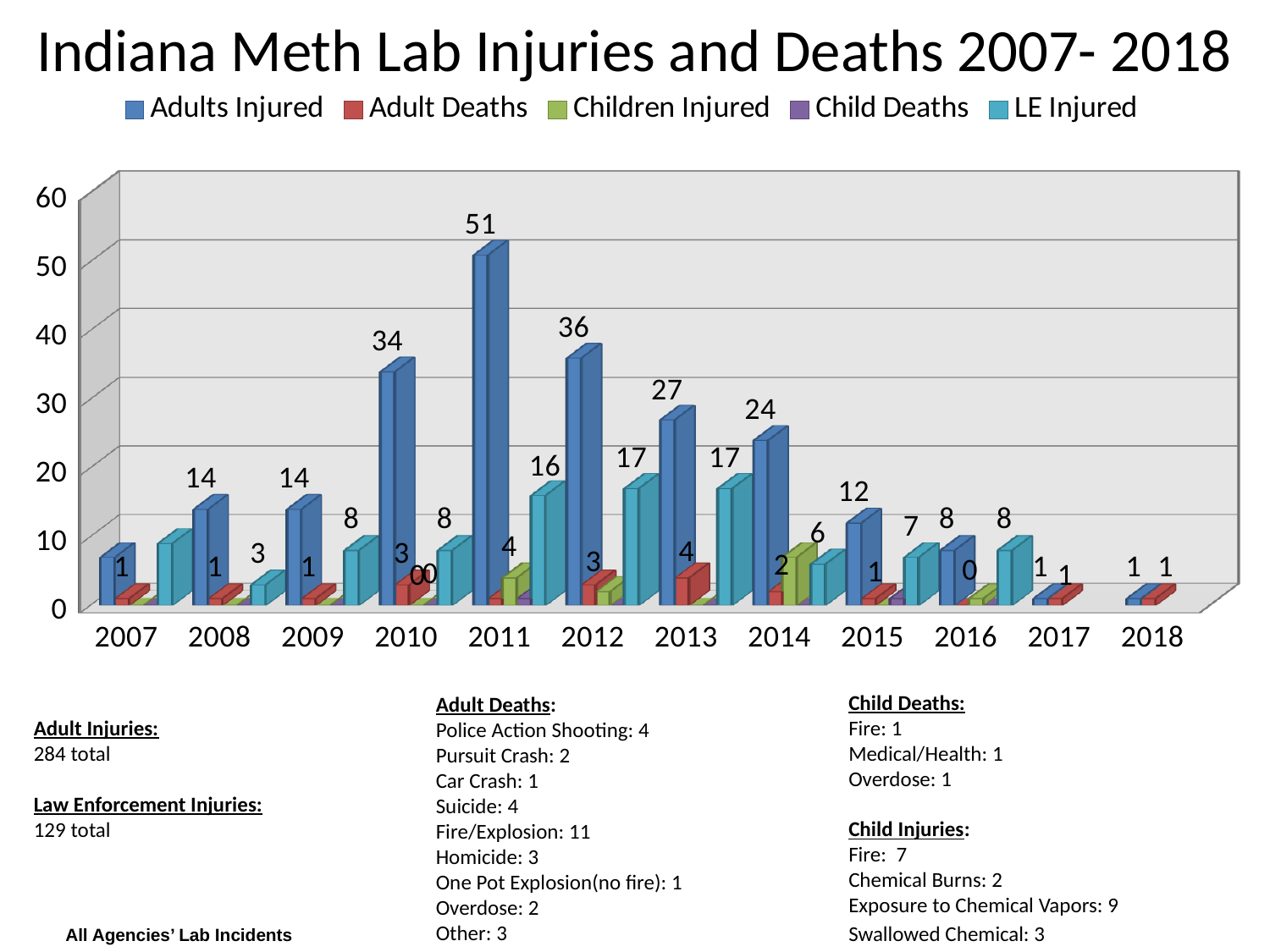
Which year has the larger Adults Injured value, 2013 or 2014? 2013 How many series does the legend list? 5 Is the Adults Injured value for 2007 greater or less than 10? less What is the difference between the Adults Injured values for 2011 and 2012? 15 What is the Adults Injured value for 2010? 34 What is the Adult Deaths value for 2013? 4 In which year was the Adults Injured value highest? 2011 Do the Adults Injured values rise or fall from 2011 to 2018? fall What type of chart is shown on the slide? bar chart How many years are shown along the x axis? 12 What is the LE Injured value for 2011? 16 What is the Adults Injured value for 2011? 51